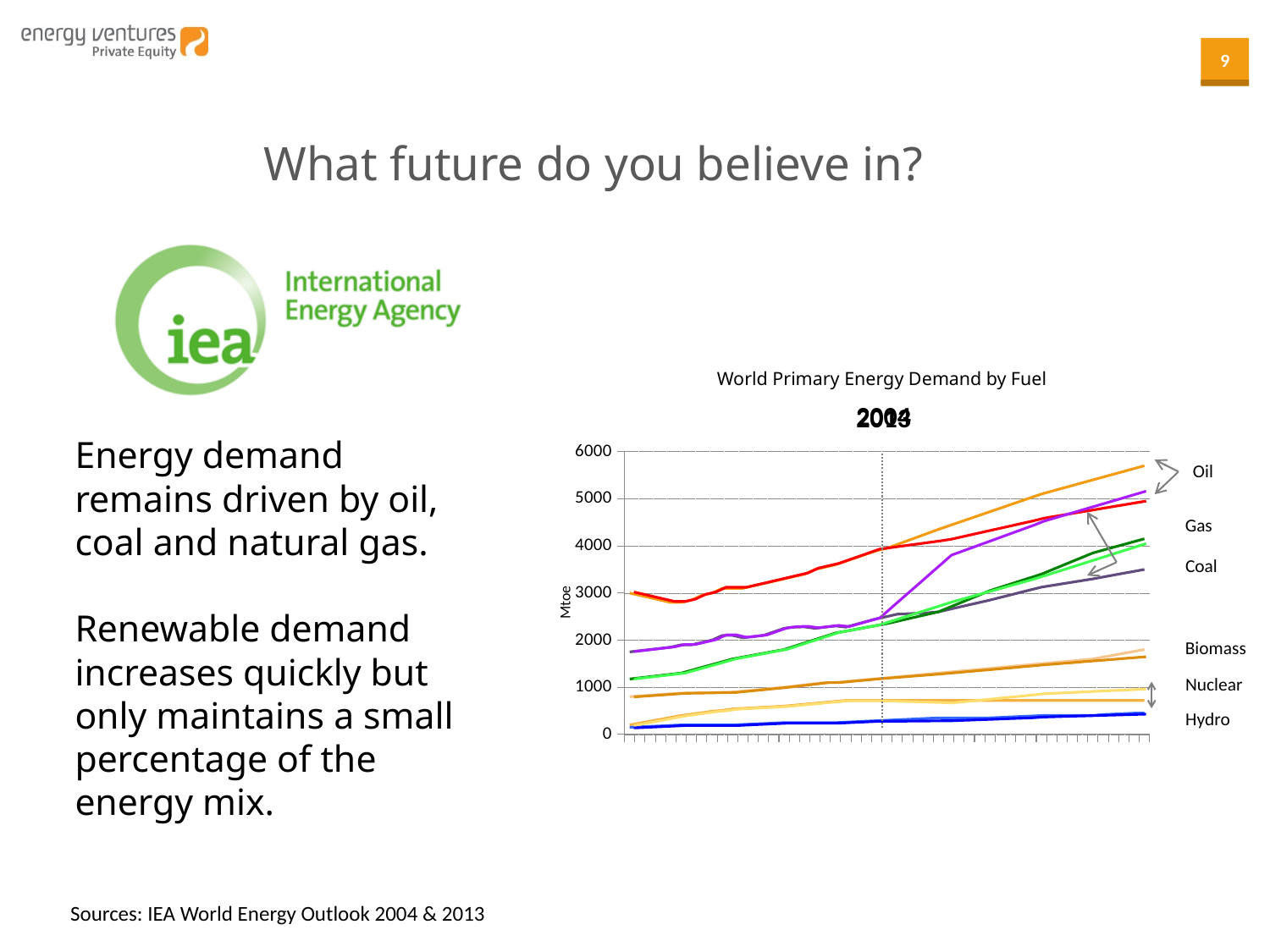
What is the title of the chart? World Primary Energy Demand by Fuel What unit is shown on the y axis of the chart? Mtoe Does the Oil line rise or fall from left to right across the chart? rise Which fuel has the highest demand at the right end of the chart? Oil How many fuel series are labelled on the chart? 6 Is the value for Hydro at the right end of the chart greater or less than 1000? less Which fuel has the lowest demand at the right end of the chart? Hydro Which is larger at the right end of the chart, the value for Oil or the value for Biomass? Oil Is the value for Biomass at the right end of the chart greater or less than 2000? less What kind of chart is shown on the slide? line chart